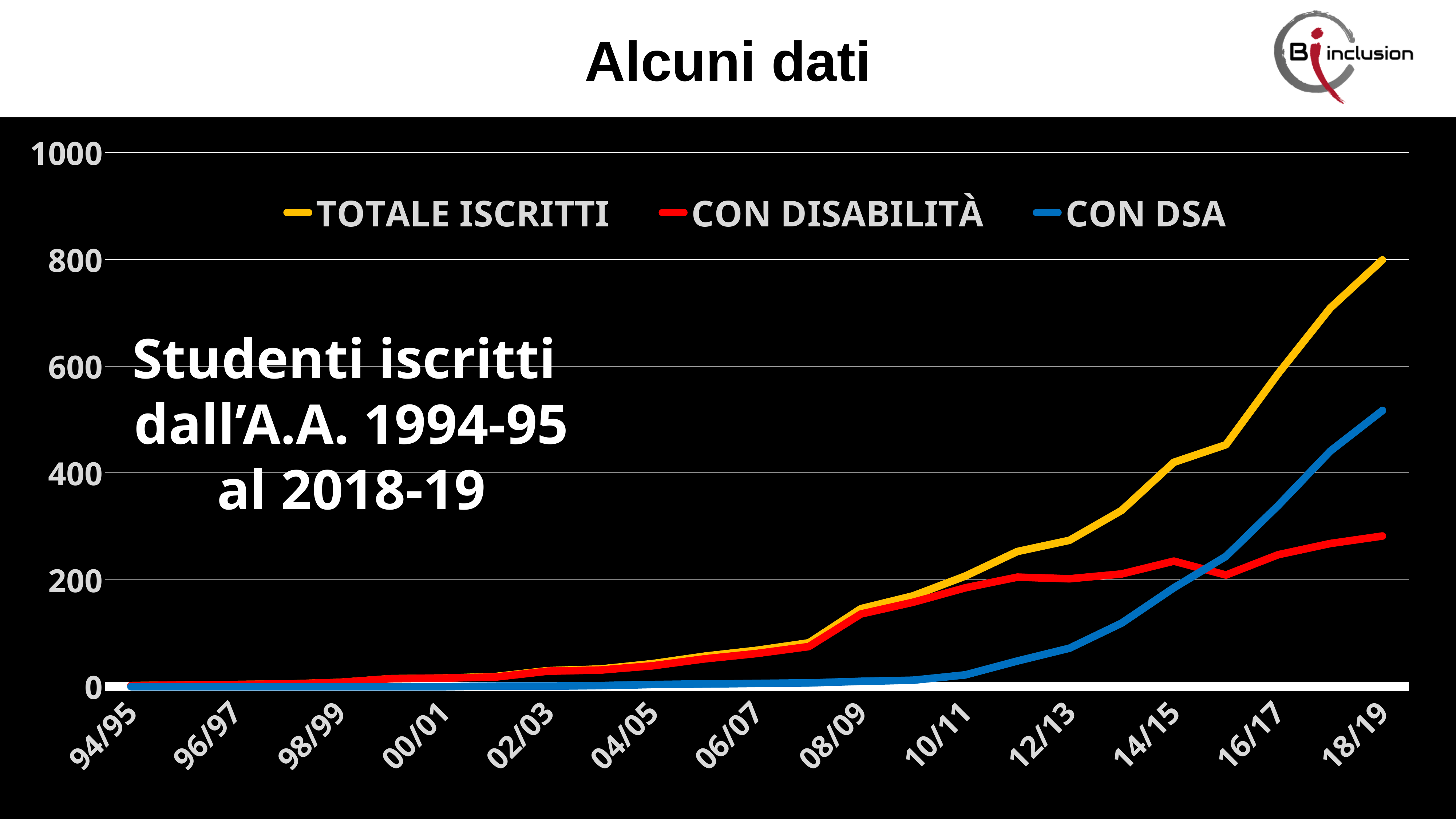
What colour is the CON DSA line in the legend? blue In 18/19, which is larger: CON DSA or CON DISABILITÀ? CON DSA Is the value for CON DISABILITÀ in 18/19 greater or less than 400? less How many series does the legend list? 3 In 14/15, which is larger: CON DISABILITÀ or CON DSA? CON DISABILITÀ How many academic-year labels are shown on the x axis? 13 Is the value for TOTALE ISCRITTI in 18/19 greater or less than 600? greater What kind of chart is shown on the slide? line chart Which series reaches the highest value in 18/19? TOTALE ISCRITTI Is the value for CON DSA in 18/19 greater or less than 400? greater Does the TOTALE ISCRITTI series rise or fall from 94/95 to 18/19? rise